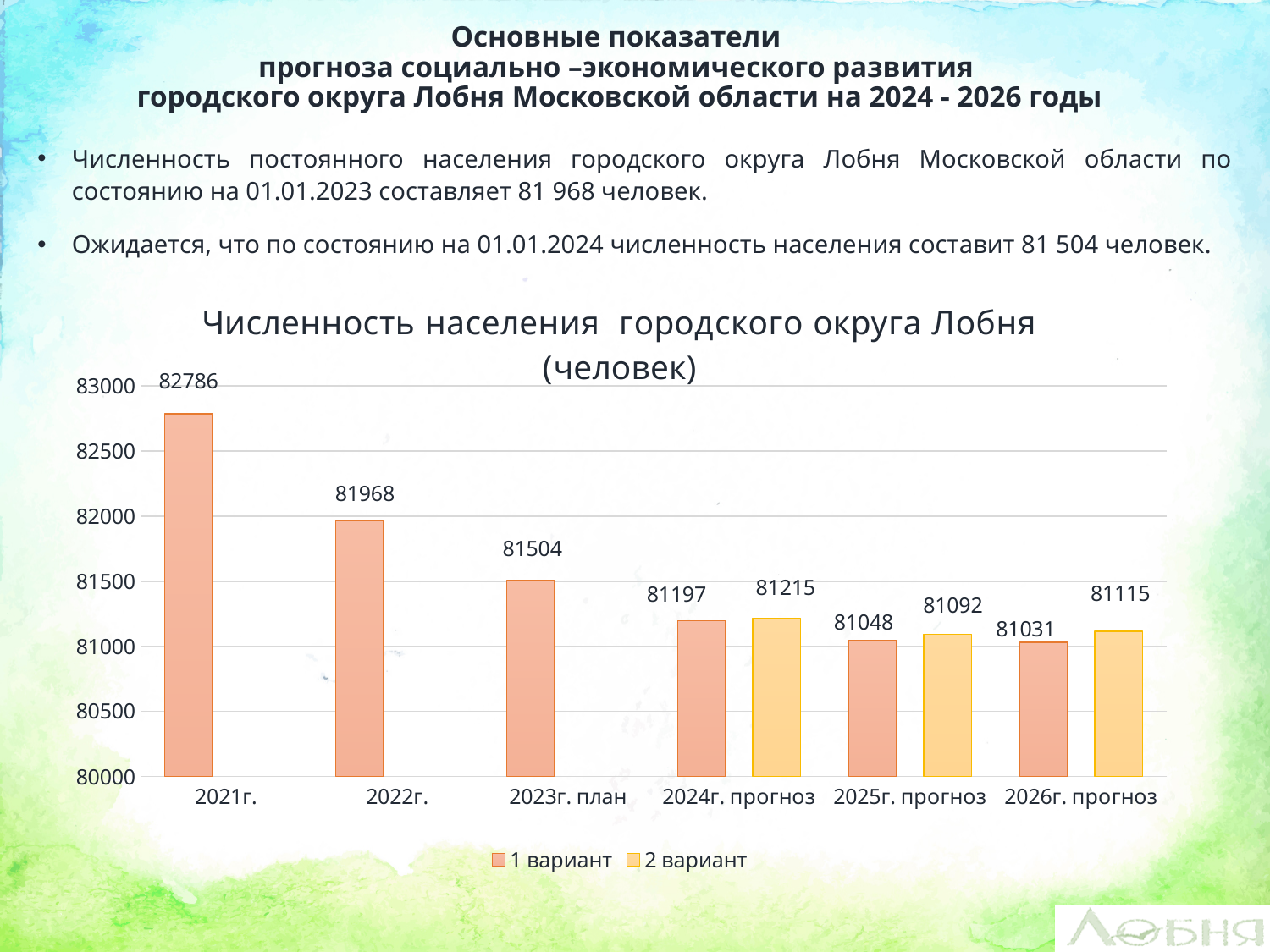
Which category has the highest value in the chart? 2021г. What is the value of the 1 вариант series for 2024г. прогноз? 81197 Do the values of the 1 вариант series rise or fall from 2021г. to 2026г. прогноз? fall What is the difference between the 2 вариант and 1 вариант values for 2025г. прогноз? 44 Which is larger for 2024г. прогноз: 1 вариант or 2 вариант? 2 вариант What kind of chart is shown on the slide? bar chart What is the difference between the values for 2021г. and 2022г.? 818 How many categories are shown on the x axis of the chart? 6 What is the value for 2021г. in the chart? 82786 How many series does the legend list? 2 What is the value of the 2 вариант series for 2026г. прогноз? 81115 Which category has the lowest value for the 1 вариант series? 2026г. прогноз